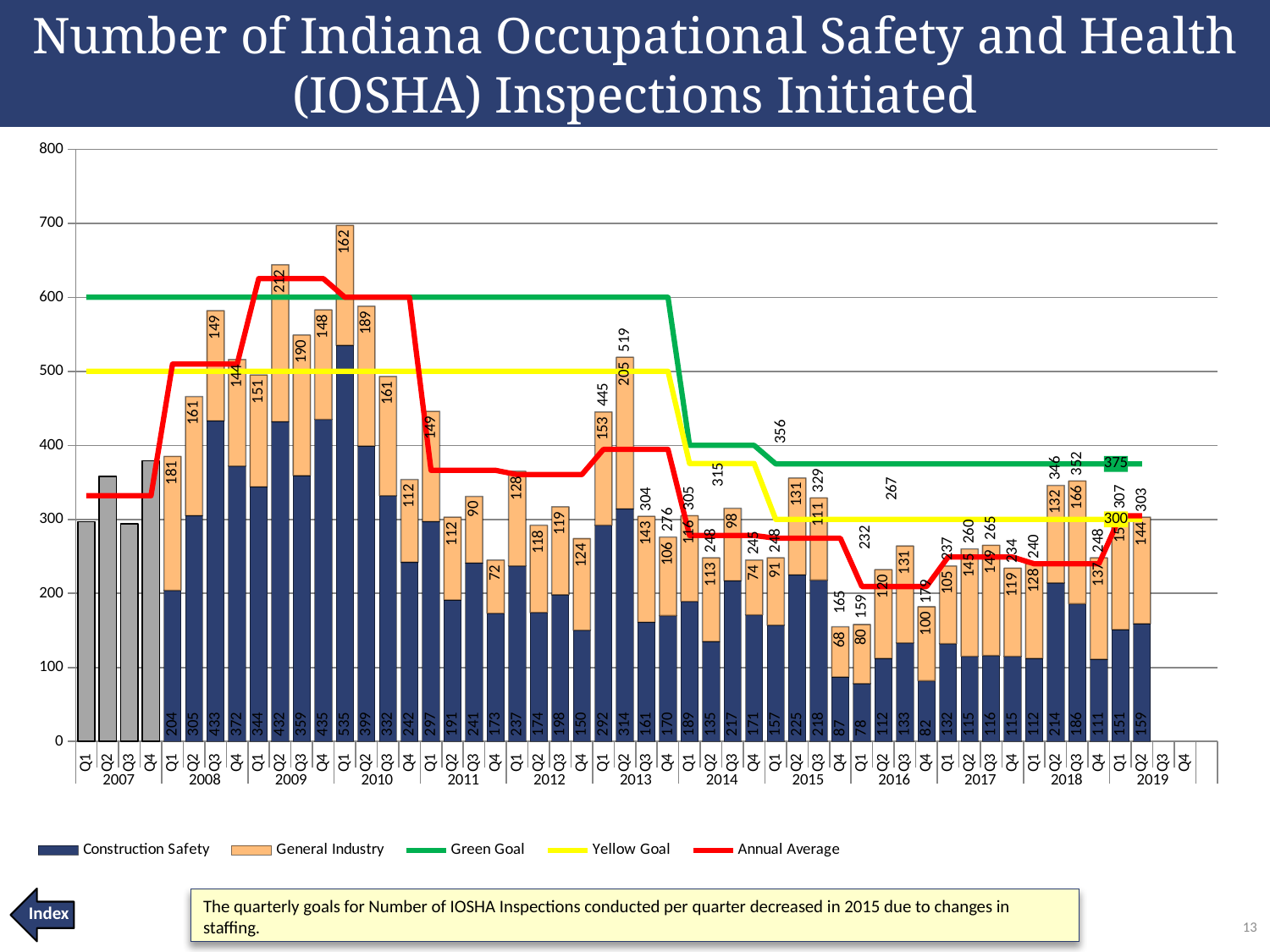
What is the General Industry value for Q2 2009? 212 Which quarter has the highest Construction Safety value? Q1 2010 What Green Goal value is labeled at the end of the chart in 2019? 375 What is the Construction Safety value for Q1 2010? 535 How many series does the legend list? 5 Is the total bar height for Q1 2010 greater or less than 600? greater What Yellow Goal value is labeled at the end of the chart in 2019? 300 What kind of chart is shown on the slide? Bar chart (stacked bars with goal and average lines) What is the difference between the Construction Safety values for Q2 2018 and Q1 2018? 102 Which quarter has the lowest Construction Safety value? Q1 2016 What is the total number of inspections for Q2 2013? 519 Which has the larger General Industry value, Q3 2018 or Q4 2018? Q3 2018